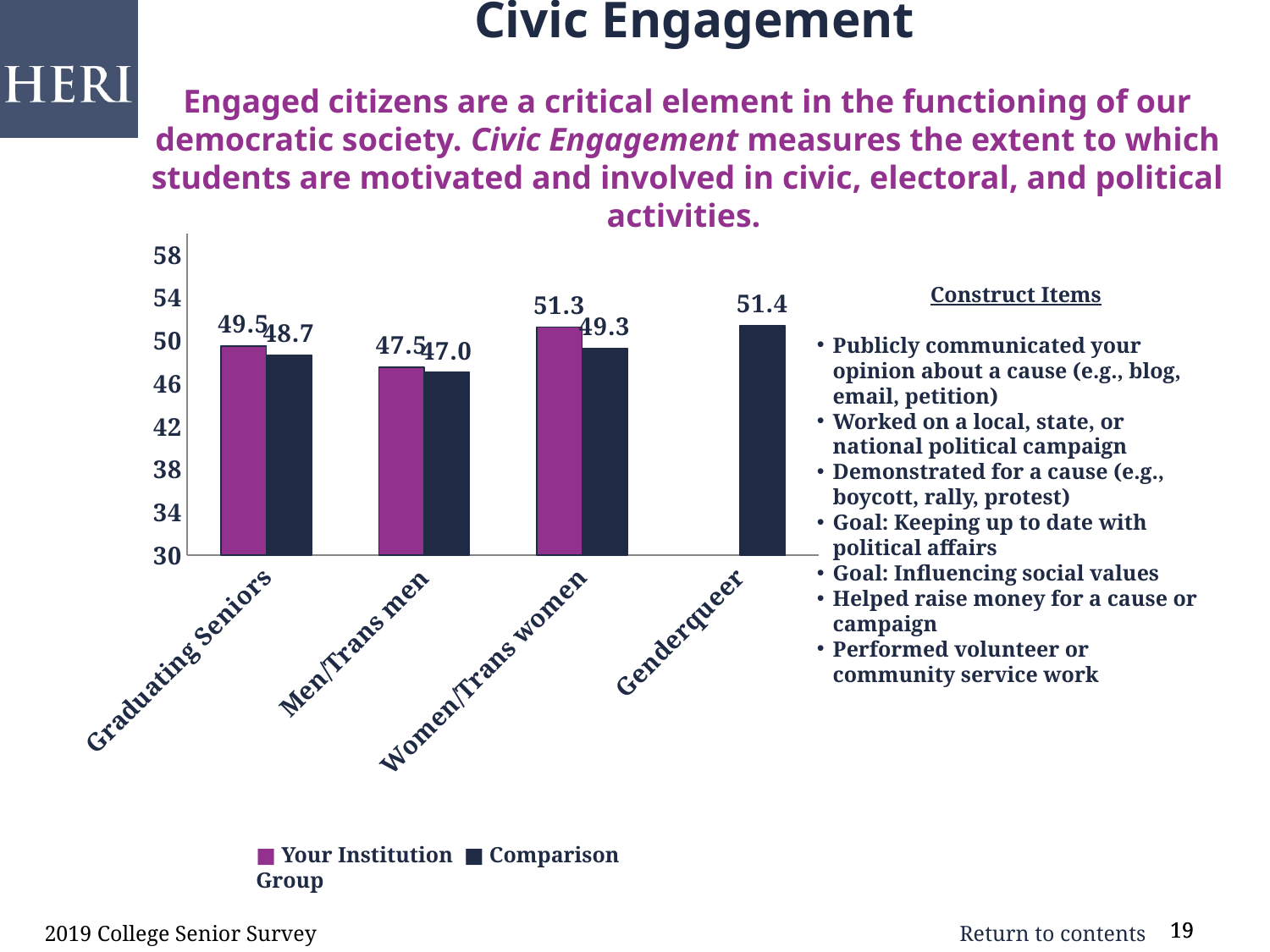
Which series is shown in purple? Your Institution What kind of chart is shown on the slide? Bar chart What is the Your Institution value for Graduating Seniors? 49.5 How many series does the legend list? 2 How many categories are shown on the x axis? 4 What is the difference between the Your Institution and Comparison Group values for Women/Trans women? 2.0 Which is larger for Graduating Seniors: the Your Institution value or the Comparison Group value? Your Institution Which category has the lowest Comparison Group value? Men/Trans men What is the Comparison Group value for Genderqueer? 51.4 Is the Comparison Group value for Genderqueer greater or less than 50? greater What is the Comparison Group value for Men/Trans men? 47.0 Which category has the highest Your Institution value? Women/Trans women